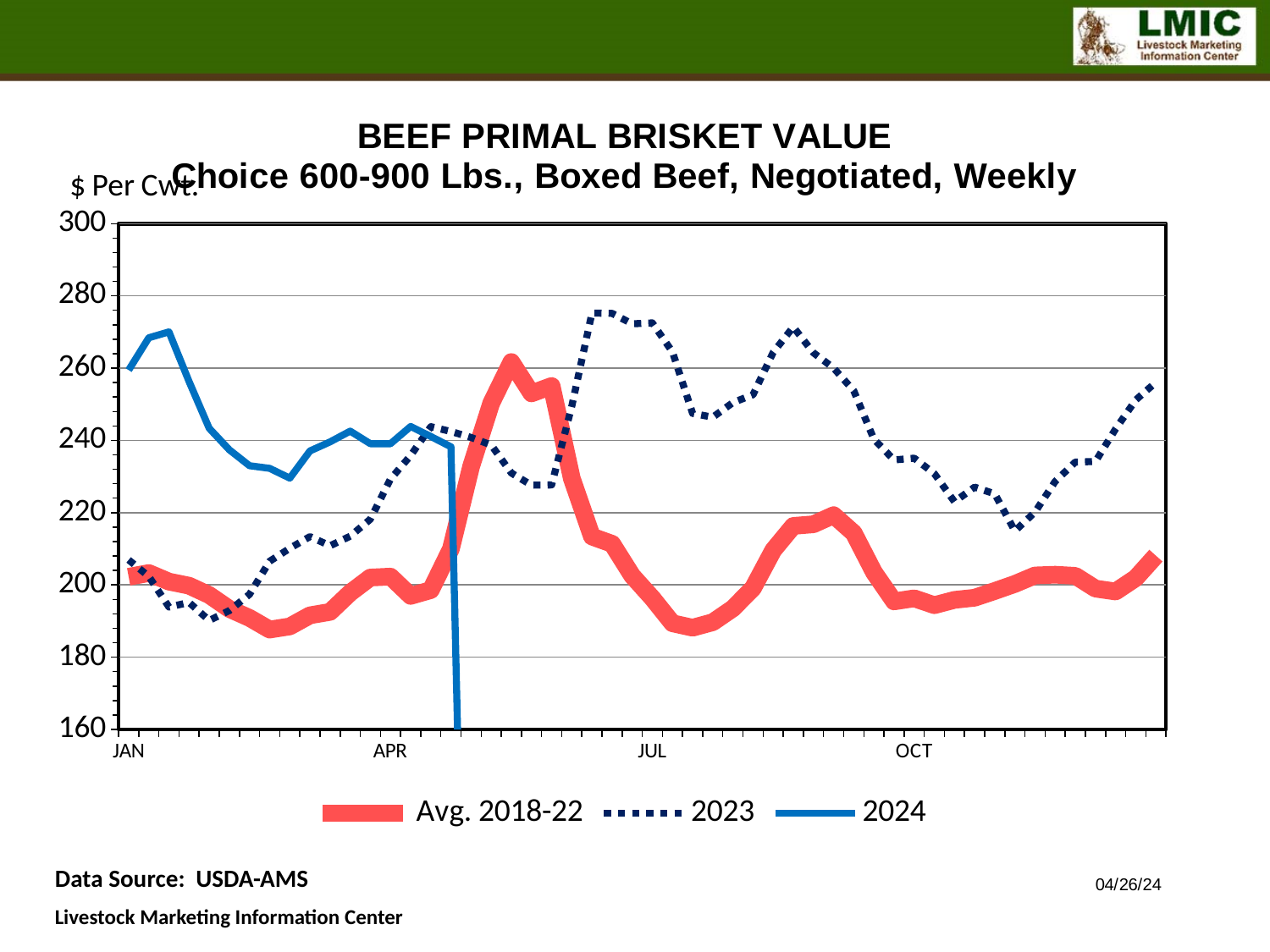
What kind of chart is shown on the slide? line chart Does the 2024 series rise or fall from JAN to mid-February? fall What unit is shown on the y-axis label? $ Per Cwt. Is the value of the Avg. 2018-22 series at JAN greater or less than 220? less Is the peak value of the 2023 series (around late June) greater or less than 260? greater Is the value of the Avg. 2018-22 series in early August greater or less than 200? less How many series does the legend list? 3 At JUL, which series has the higher value: 2023 or Avg. 2018-22? 2023 At JAN, which series has the higher value: 2024 or Avg. 2018-22? 2024 What is the title of the chart? BEEF PRIMAL BRISKET VALUE, Choice 600-900 Lbs., Boxed Beef, Negotiated, Weekly How many month labels are shown on the x axis? 4